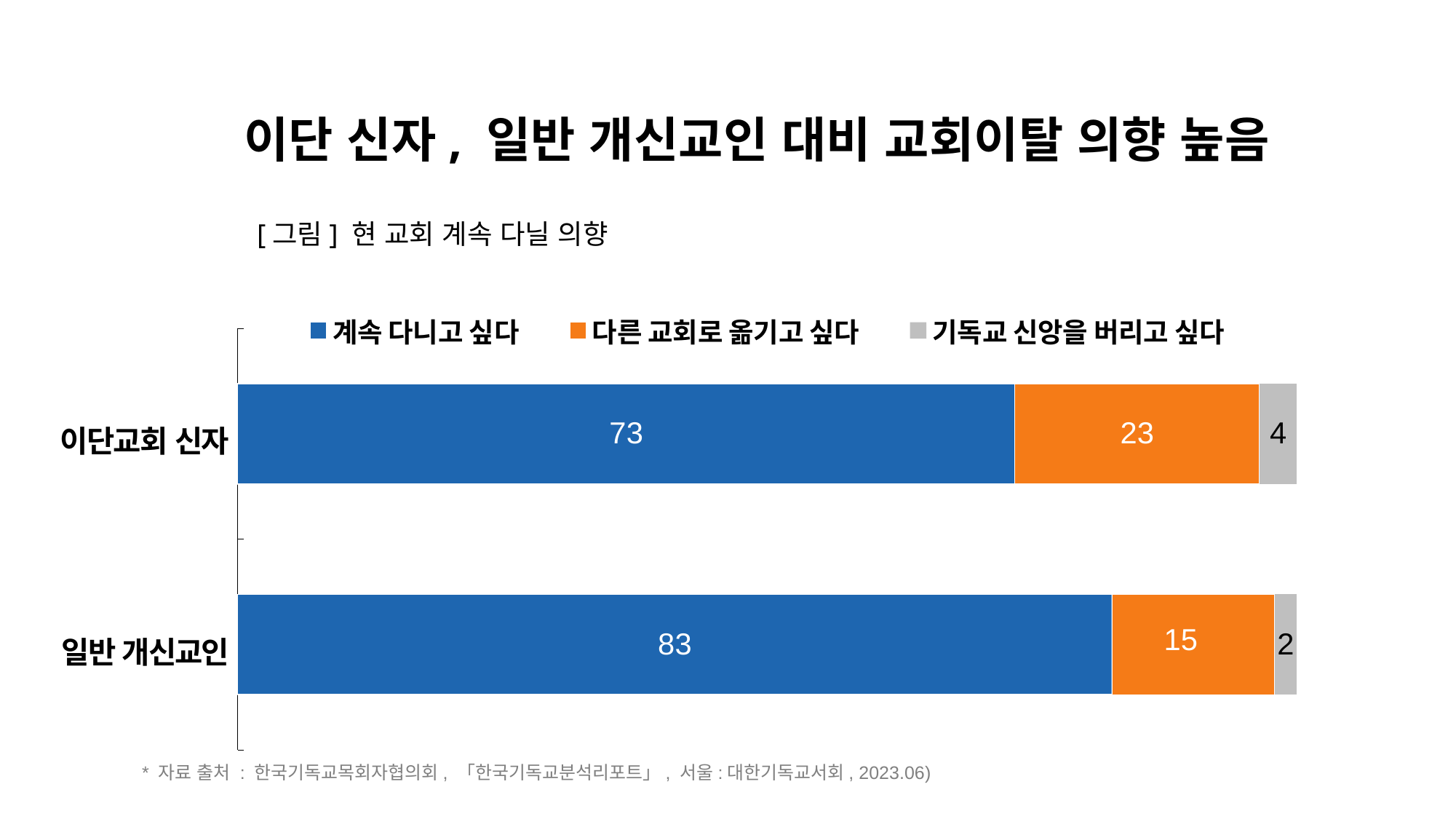
Which category has the higher value for 계속 다니고 싶다, 이단교회 신자 or 일반 개신교인? 일반 개신교인 What is the value for 계속 다니고 싶다 for 일반 개신교인? 83 How many categories are shown on the chart? 2 What is the value for 다른 교회로 옮기고 싶다 for 일반 개신교인? 15 What is the difference between the 다른 교회로 옮기고 싶다 values for 이단교회 신자 and 일반 개신교인? 8 What is the value for 기독교 신앙을 버리고 싶다 for 이단교회 신자? 4 What is the difference between the 계속 다니고 싶다 values for 일반 개신교인 and 이단교회 신자? 10 Which category has the lower value for 다른 교회로 옮기고 싶다? 일반 개신교인 What is the total of the stacked bar for 이단교회 신자? 100 What is the value for 계속 다니고 싶다 for 이단교회 신자? 73 What kind of chart is shown on the slide? Stacked bar chart How many series does the legend list? 3